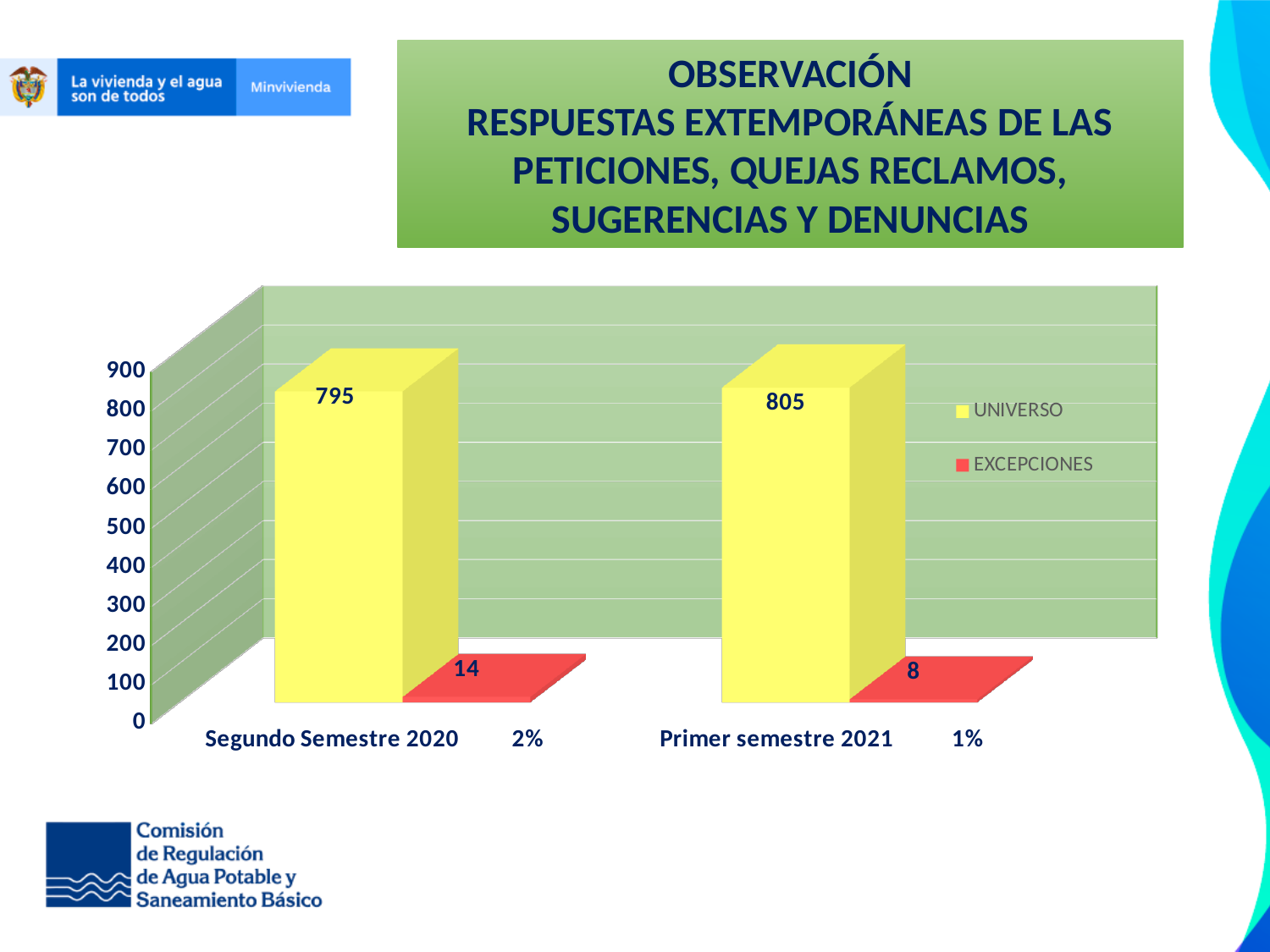
What is the difference between the UNIVERSO values for Primer semestre 2021 and Segundo Semestre 2020? 10 What is the EXCEPCIONES value for Segundo Semestre 2020? 14 What is the UNIVERSO value for Segundo Semestre 2020? 795 Is the UNIVERSO value for Primer semestre 2021 greater or less than 700? greater Which period has the lower UNIVERSO value? Segundo Semestre 2020 What kind of chart is shown on the slide? bar chart What is the UNIVERSO value for Primer semestre 2021? 805 What colour represents the EXCEPCIONES series in the legend? red Which period has the higher EXCEPCIONES value? Segundo Semestre 2020 What is the difference between the EXCEPCIONES values for Segundo Semestre 2020 and Primer semestre 2021? 6 How many series does the legend list? 2 What is the EXCEPCIONES value for Primer semestre 2021? 8